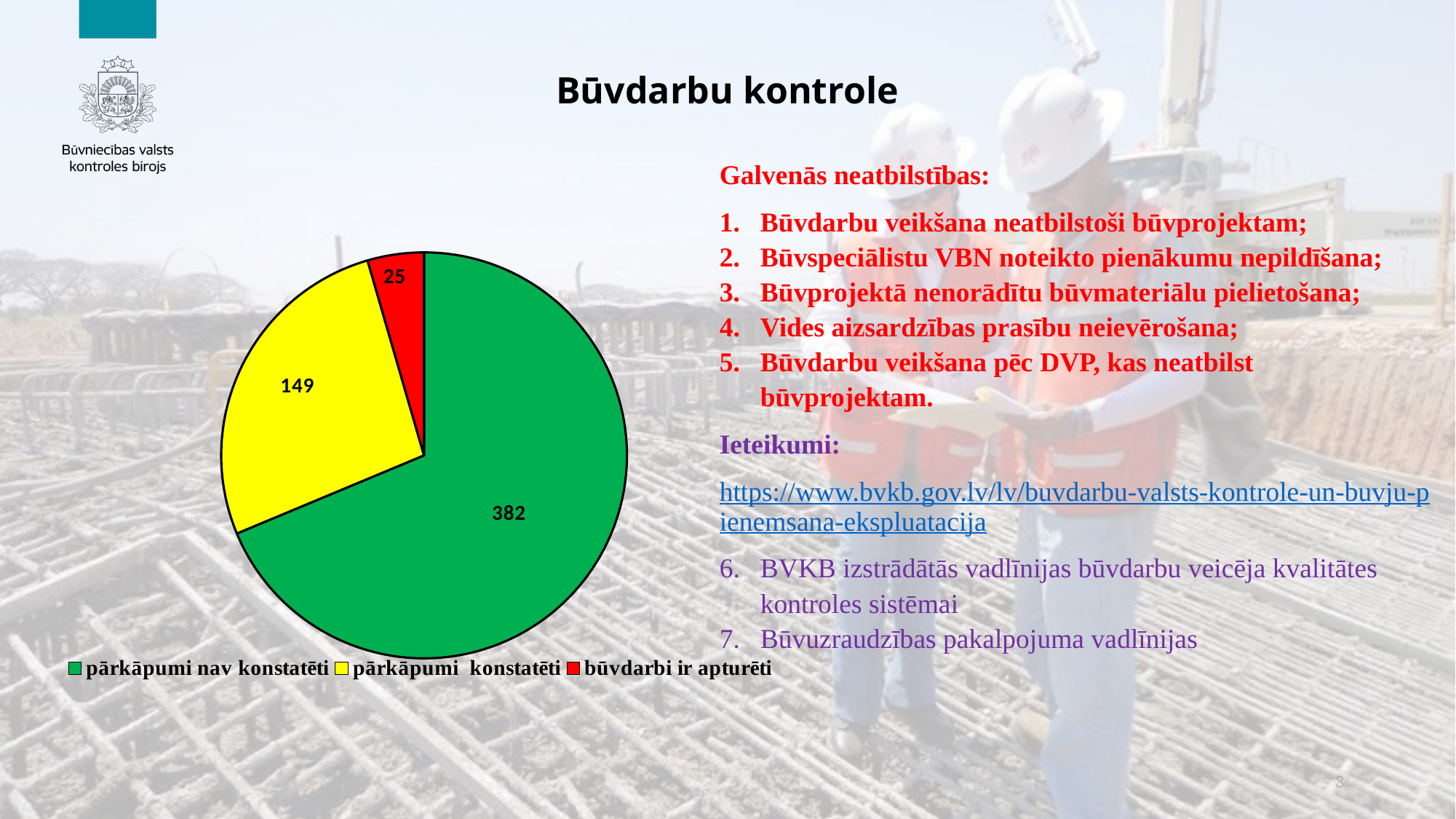
Which category has the largest slice of the pie? pārkāpumi nav konstatēti What is the difference between the values for "pārkāpumi konstatēti" and "būvdarbi ir apturēti"? 124 Which category has the smallest slice of the pie? būvdarbi ir apturēti What colour is the slice for "būvdarbi ir apturēti"? red How many slices does the pie chart have? 3 What is the difference between the values for "pārkāpumi nav konstatēti" and "pārkāpumi konstatēti"? 233 What is the value for "būvdarbi ir apturēti"? 25 What is the value for "pārkāpumi nav konstatēti"? 382 Which is larger: the value for "pārkāpumi konstatēti" or the value for "būvdarbi ir apturēti"? pārkāpumi konstatēti What type of chart is shown on the slide? pie chart What is the total of all slices in the pie chart? 556 What is the value for "pārkāpumi konstatēti"? 149